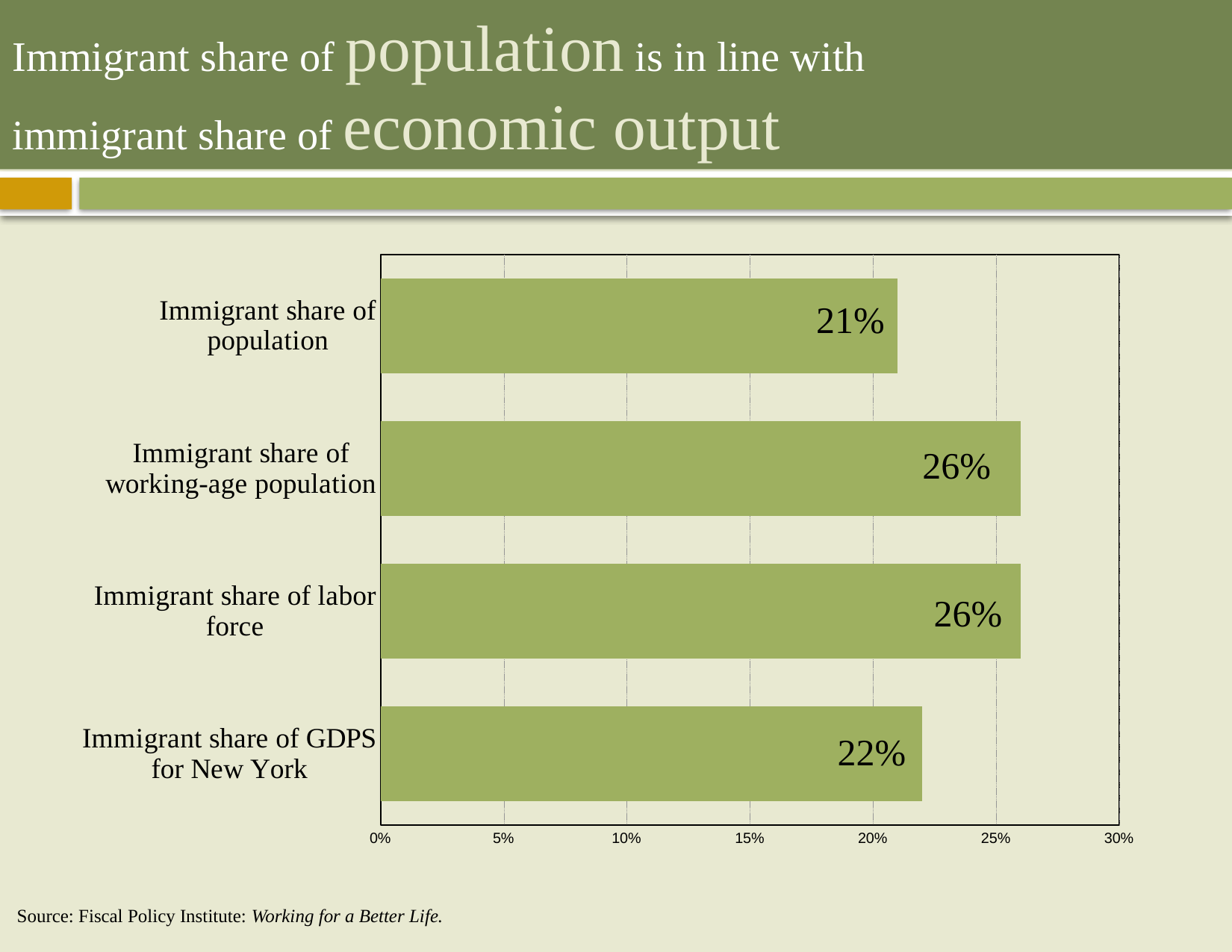
What is the value for Immigrant share of labor force? 26% Which is larger, Immigrant share of labor force or Immigrant share of GDPS for New York? Immigrant share of labor force Is the value for Immigrant share of population greater or less than 25%? less Which category has the lowest value? Immigrant share of population Is the value for Immigrant share of working-age population greater or less than 25%? greater How many categories are shown in the chart? 4 What is the value for Immigrant share of GDPS for New York? 22% What is the value for Immigrant share of working-age population? 26% What is the difference between Immigrant share of working-age population and Immigrant share of population? 5% What is the value for Immigrant share of population? 21% What is the difference between Immigrant share of GDPS for New York and Immigrant share of population? 1% What kind of chart is shown on the slide? Bar chart